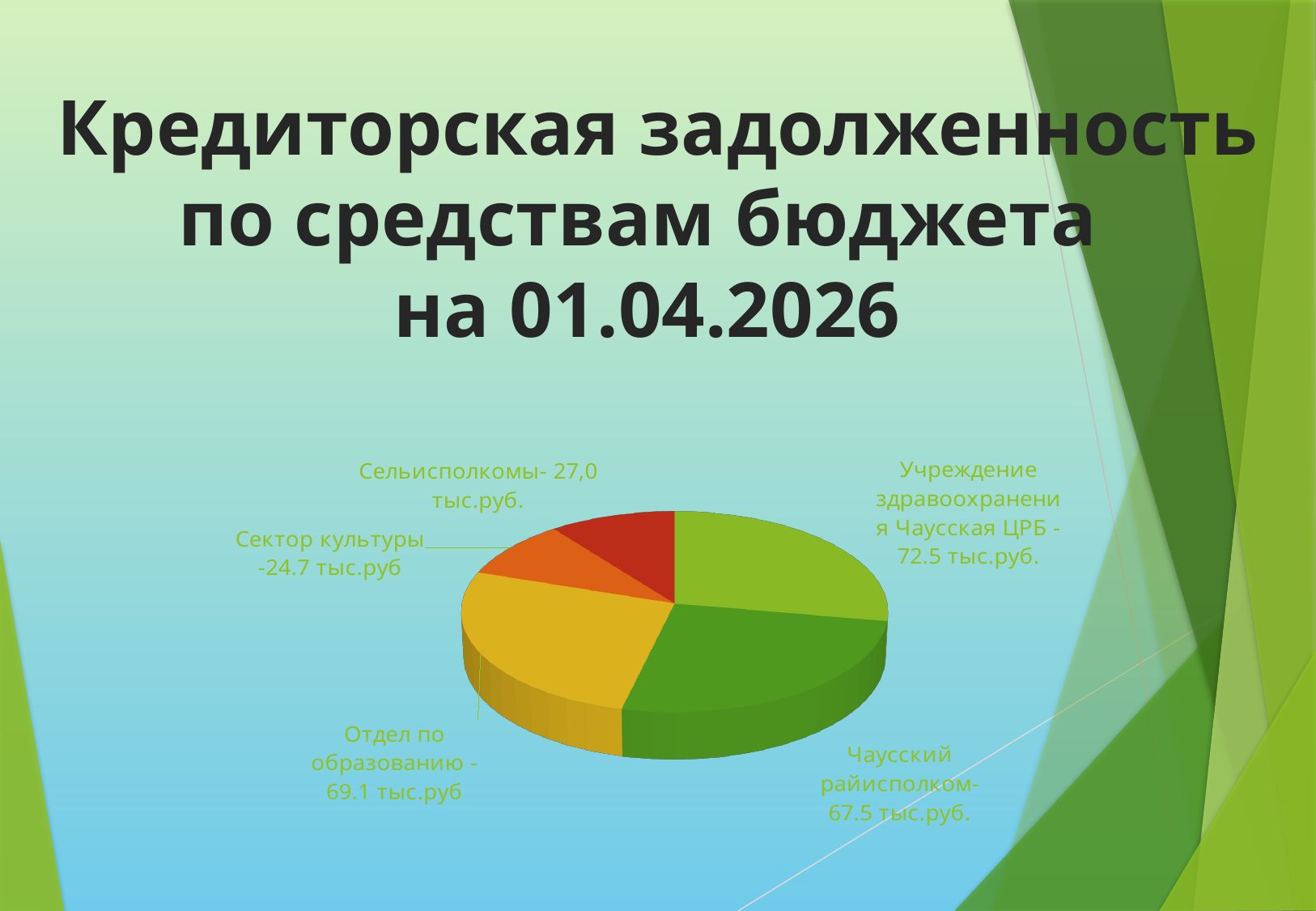
What is the value for Сектор культуры? 24.7 тыс.руб What is the value for Отдел по образованию? 69.1 тыс.руб What is the title of the slide containing the pie chart? Кредиторская задолженность по средствам бюджета на 01.04.2026 What is the value for Учреждение здравоохранения Чаусская ЦРБ? 72.5 тыс.руб. What is the difference between the values for Сельисполкомы and Сектор культуры? 2.3 тыс.руб. How many slices does the pie chart have? 5 What is the value for Сельисполкомы? 27,0 тыс.руб. What is the difference between the values for Учреждение здравоохранения Чаусская ЦРБ and Сектор культуры? 47.8 тыс.руб. Which category has the smallest value in the pie chart? Сектор культуры What kind of chart is shown on the slide? pie chart Which category has the largest value in the pie chart? Учреждение здравоохранения Чаусская ЦРБ Which is larger, the value for Отдел по образованию or for Чаусский райисполком? Отдел по образованию